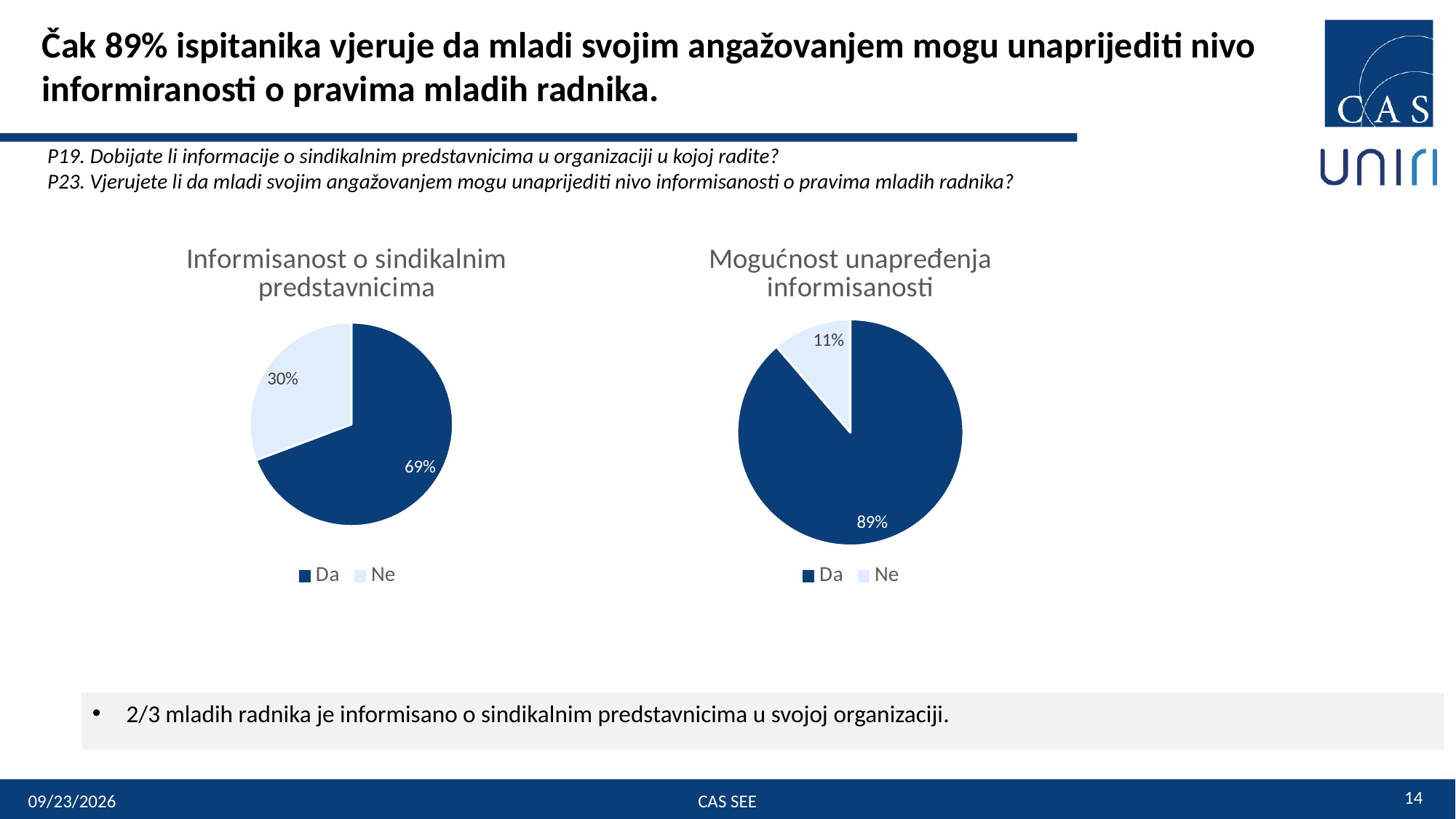
In the chart titled "Mogućnost unapređenja informisanosti", what colour is the Ne slice? light blue How many categories does the legend of the chart titled "Informisanost o sindikalnim predstavnicima" list? 2 In the chart titled "Mogućnost unapređenja informisanosti", what is the value for Ne? 11% In the chart titled "Mogućnost unapređenja informisanosti", which category has the smallest slice? Ne In the chart titled "Informisanost o sindikalnim predstavnicima", what is the value for Ne? 30% In the chart titled "Mogućnost unapređenja informisanosti", what is the difference between the Da and Ne values? 78% In the chart titled "Informisanost o sindikalnim predstavnicima", what is the value for Da? 69% Is the Da value in the left chart ("Informisanost o sindikalnim predstavnicima") larger or smaller than the Da value in the right chart ("Mogućnost unapređenja informisanosti")? smaller In the chart titled "Informisanost o sindikalnim predstavnicima", which category has the largest slice? Da What type of chart is the chart titled "Mogućnost unapređenja informisanosti"? pie chart In the chart titled "Mogućnost unapređenja informisanosti", what is the value for Da? 89% In the chart titled "Informisanost o sindikalnim predstavnicima", what is the difference between the Da and Ne values? 39%